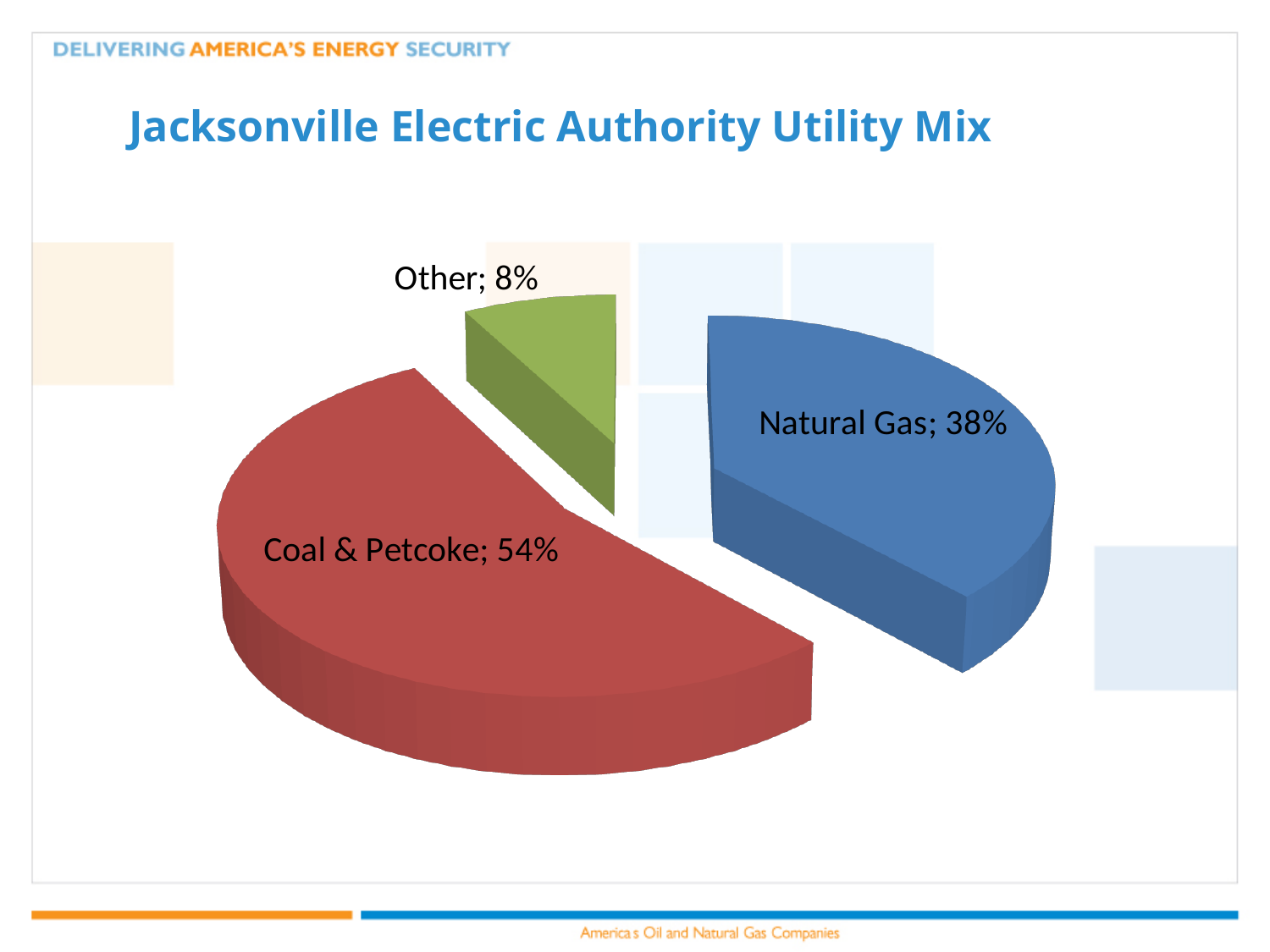
What share of the Jacksonville Electric Authority utility mix is Coal & Petcoke? 54% How many percentage points larger is the Coal & Petcoke share than the Natural Gas share? 16 What share of the utility mix is Other? 8% Which category has the smallest share of the utility mix? Other How many percentage points larger is the Natural Gas share than the Other share? 30 How many categories are shown in the pie chart? 3 What share of the utility mix is Natural Gas? 38% Which is larger, the Natural Gas share or the Other share? Natural Gas What colour is the Natural Gas slice? Blue Which category has the largest share of the utility mix? Coal & Petcoke What kind of chart is shown on the slide? Pie chart What is the title of the chart? Jacksonville Electric Authority Utility Mix